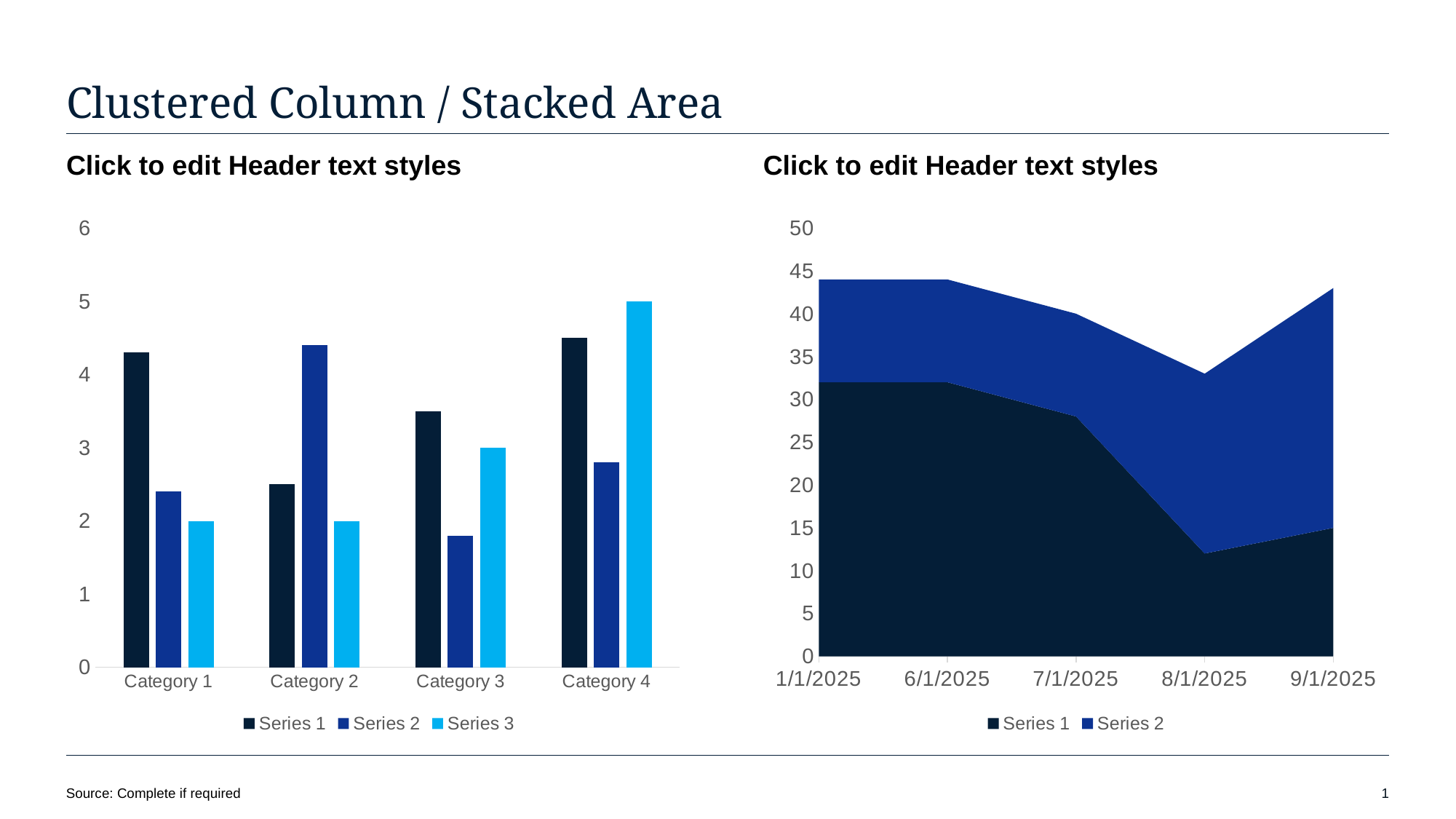
In the left chart, what is the value of Series 3 for Category 4? 5 In the left chart, for Category 2, which is larger: Series 1 or Series 2? Series 2 In the right chart, is the value of Series 1 at 8/1/2025 greater or less than 20? less What kind of chart is the chart on the left of the slide? bar chart In the left chart, which category has the highest value for Series 3? Category 4 In the right chart, how many series does the legend list? 2 In the left chart, how many series does the legend list? 3 What kind of chart is the chart on the right of the slide? stacked area chart In the right chart, how many dates are shown on the x axis? 5 In the left chart, how many categories are shown on the x axis? 4 In the right chart, is the stacked total at 1/1/2025 greater or less than 40? greater In the right chart, at which date is Series 1 at its lowest? 8/1/2025